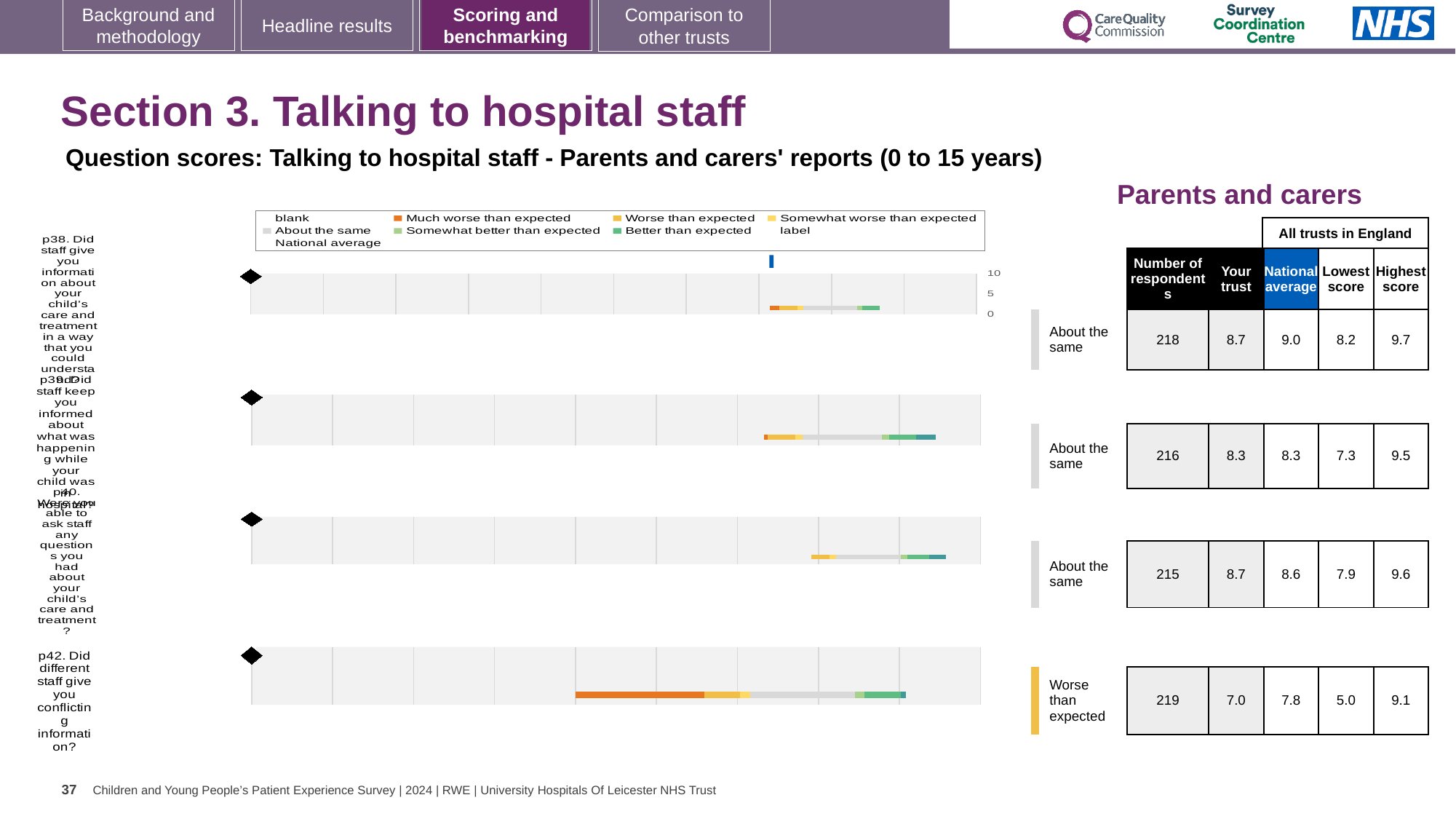
What colour does the legend use for 'Much worse than expected'? orange In the table next to the chart, what is the 'Your trust' score for p42 (Did different staff give you conflicting information?)? 7.0 For p42, what is the difference between the National average (7.8) and the Your trust score (7.0)? 0.8 How many survey questions (rows) are plotted in the benchmarking chart? 4 Which question has the lowest 'Your trust' score in the table next to the chart? p42. Did different staff give you conflicting information? What is the Lowest score across all trusts in England for p42? 5.0 What benchmark category is shown for p42 (Did different staff give you conflicting information?)? Worse than expected In the table next to the chart, how many respondents are listed for p38 (Did staff give you information about your child's care and treatment in a way that you could understand?)? 218 For p40 (Were you able to ask staff any questions you had about your child's care and treatment?), which is larger: the Your trust score or the National average? Your trust What kind of chart is used to show the question scores on this slide? bar chart What is the Highest score across all trusts in England for p39 (Did staff keep you informed about what was happening while your child was in hospital?)? 9.5